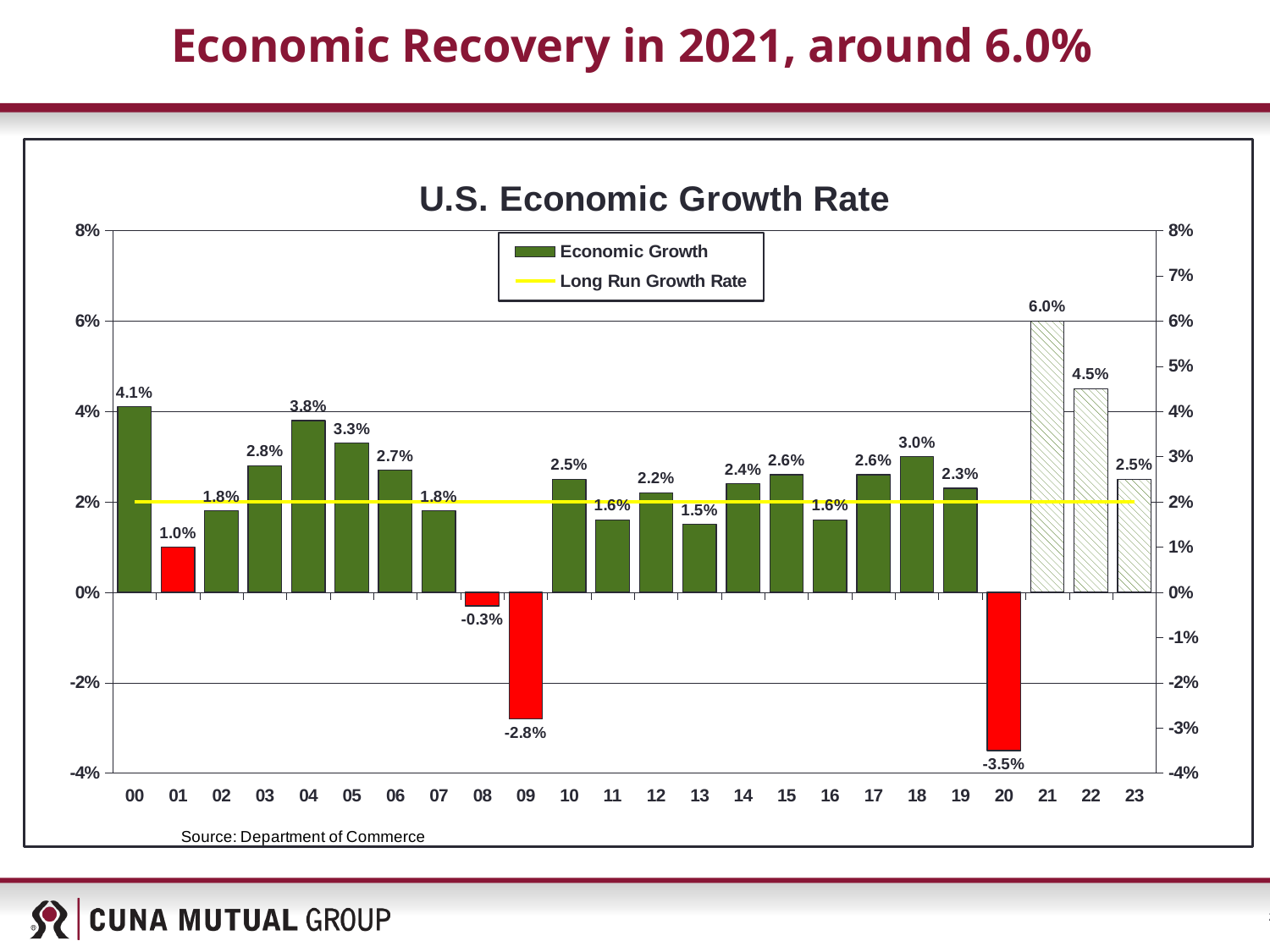
Which year has the lowest economic growth rate on the chart? 20 What is the economic growth rate shown for 2021? 6.0% What is the difference between the growth rate in 2021 and the growth rate in 2022? 1.5% What is the economic growth rate shown for 2018? 3.0% Which year has the larger growth rate, 2004 or 2005? 04 What kind of chart is used to show the economic growth rate? Bar chart How many series does the legend list? 2 Which year has the highest economic growth rate on the chart? 21 What is the title of the chart? U.S. Economic Growth Rate What is the economic growth rate shown for 2009? -2.8% How many years are shown on the x axis of the chart? 24 What is the source cited below the chart? Department of Commerce